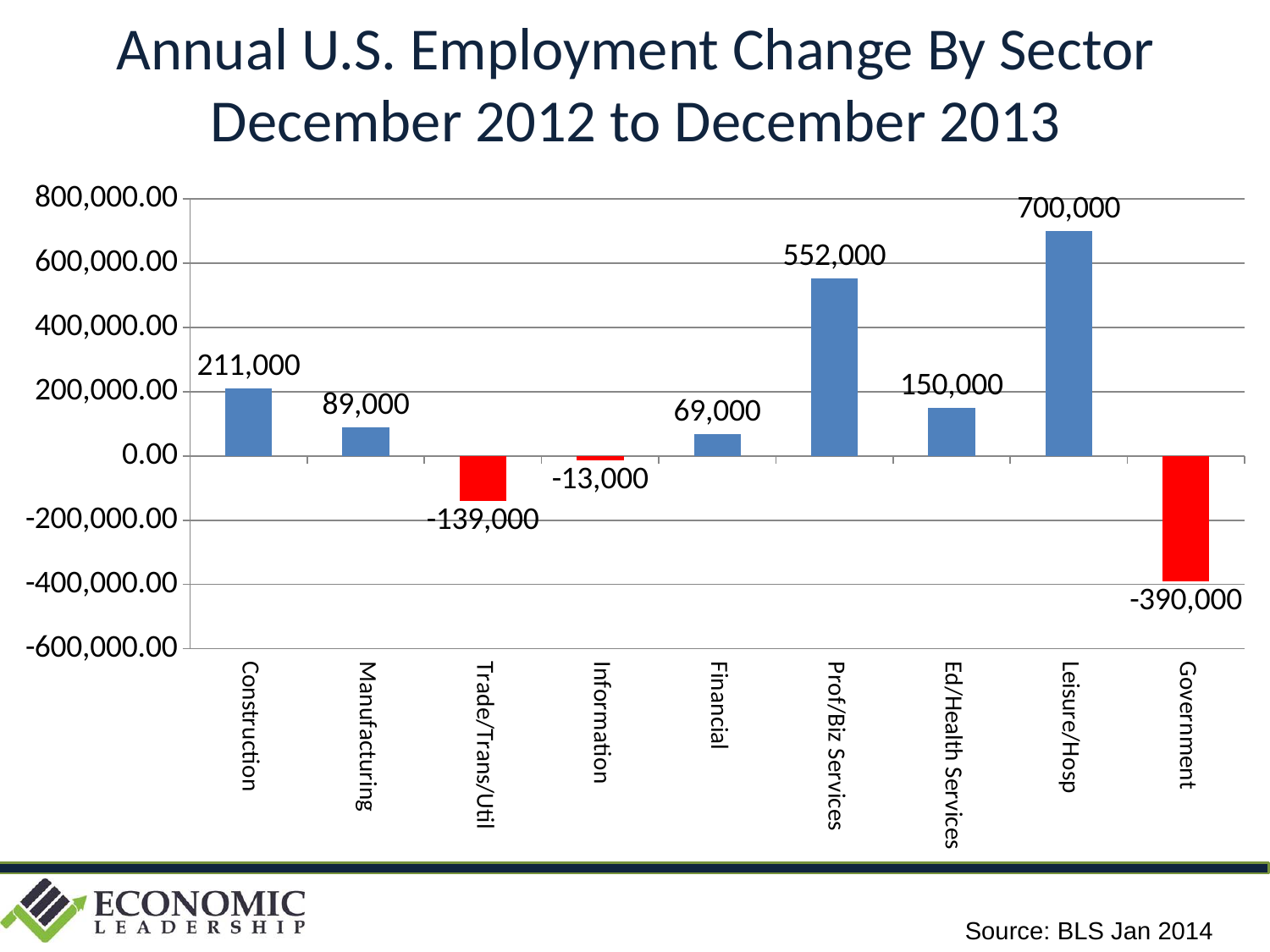
Which sector has the highest employment change? Leisure/Hosp What is the employment change for Construction? 211,000 What is the employment change for Information? -13,000 What is the employment change for Government? -390,000 What is the difference between the employment change for Leisure/Hosp and Prof/Biz Services? 148,000 What colour are the bars with negative values? Red What is the difference between the employment change for Trade/Trans/Util and Information? 126,000 Is the value for Ed/Health Services greater or less than 200,000.00? less Which sector has the lowest employment change? Government What kind of chart is shown on the slide? Bar chart Which is larger, the employment change for Manufacturing or Financial? Manufacturing How many sectors are shown on the chart? 9